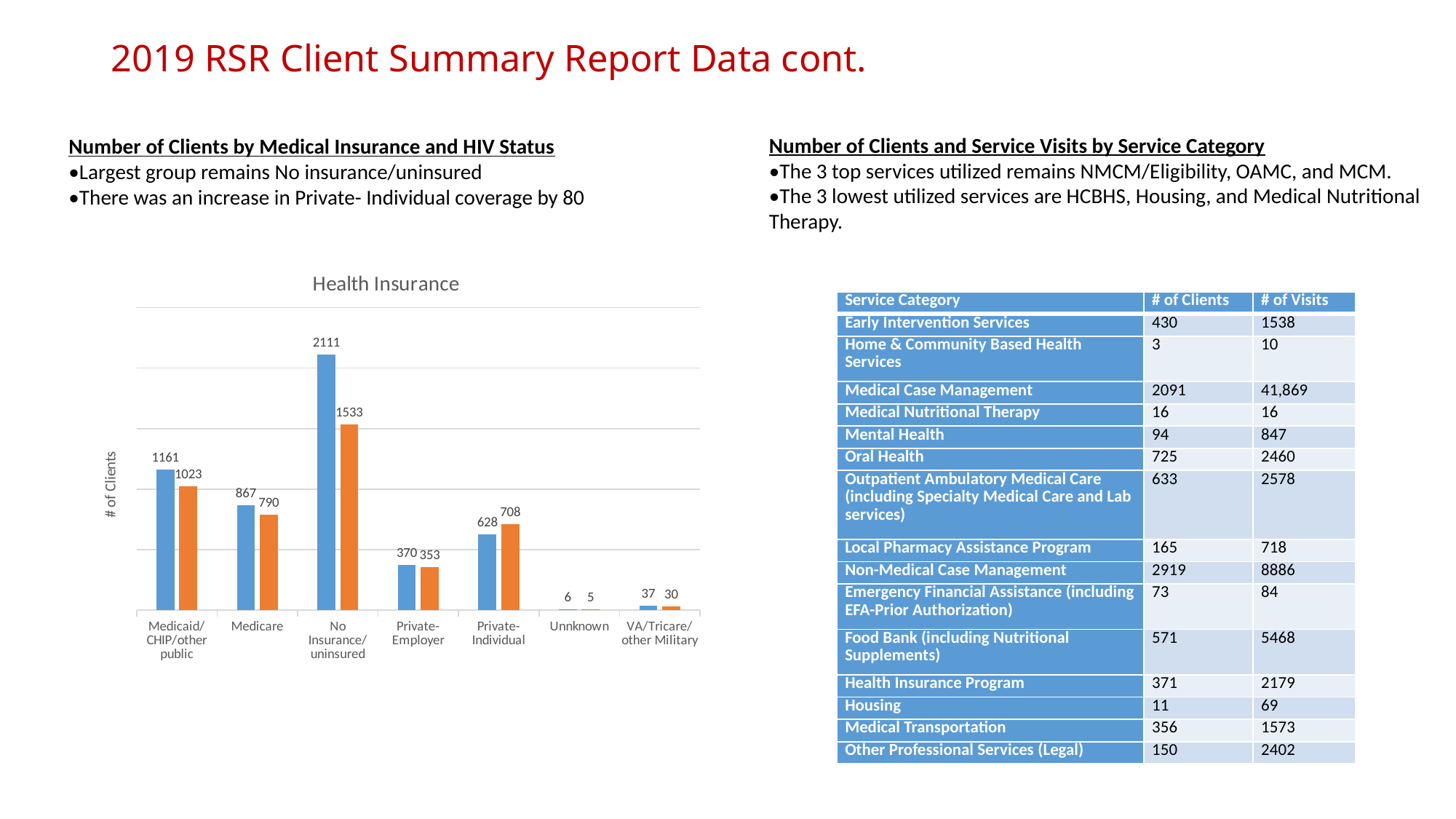
What is the value of the blue bar for VA/Tricare/other Military in the Health Insurance chart? 37 In the Health Insurance chart, what is the difference between the orange and blue bars for Private-Individual? 80 What kind of chart is the Health Insurance chart? bar chart In the Health Insurance chart, is the blue bar or the orange bar larger for Private-Individual? orange What is the value of the orange bar for Medicare in the Health Insurance chart? 790 Which category has the lowest orange bar in the Health Insurance chart? Unnknown In the Health Insurance chart, what is the difference between the blue and orange bars for No Insurance/uninsured? 578 What is the value of the orange bar for Private-Individual in the Health Insurance chart? 708 How many categories are shown on the x axis of the Health Insurance chart? 7 What is the value of the blue bar for No Insurance/uninsured in the Health Insurance chart? 2111 Which category has the highest blue bar in the Health Insurance chart? No Insurance/uninsured What is the label on the vertical axis of the Health Insurance chart? # of Clients